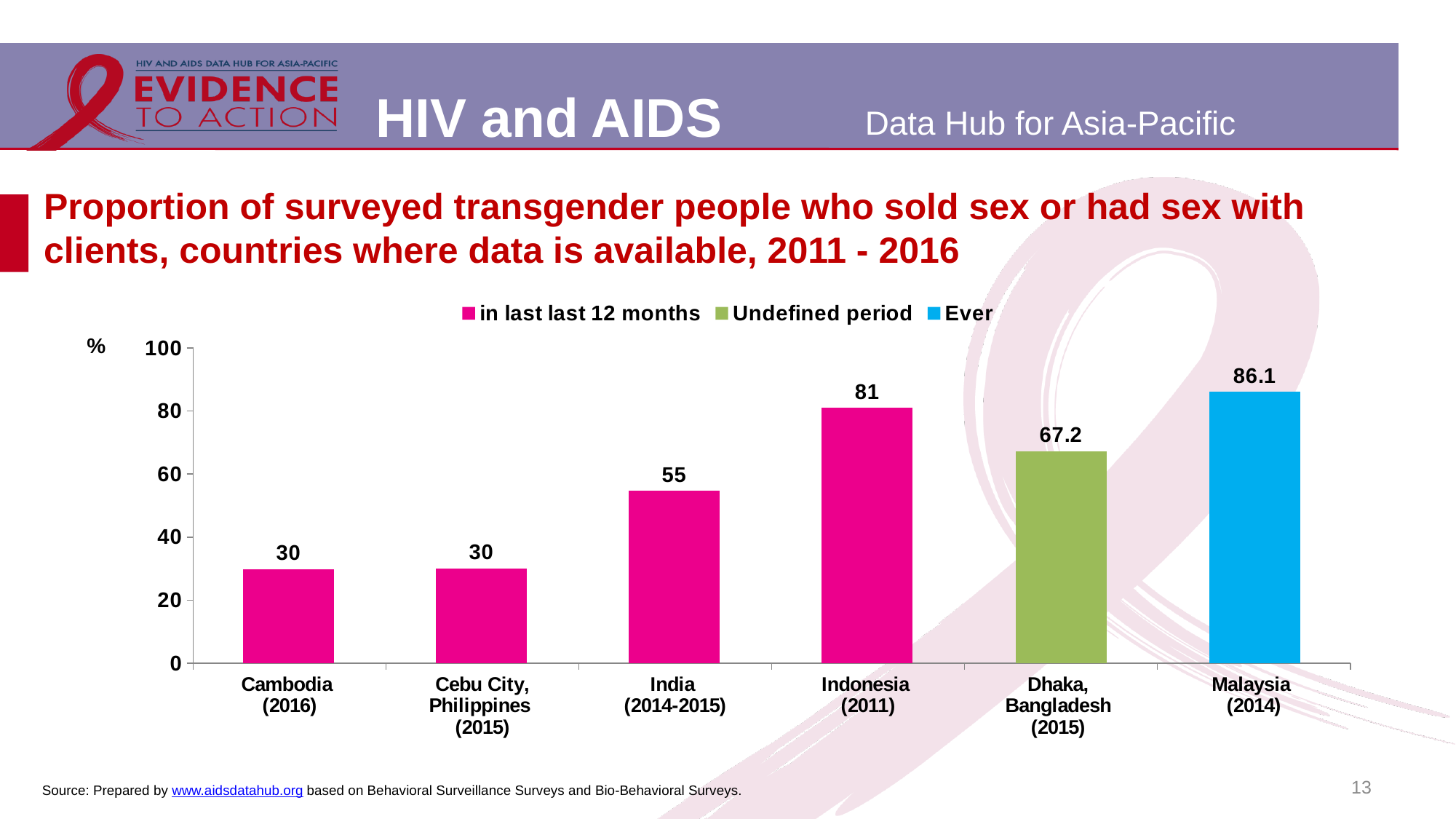
What is the difference between the values for Indonesia (2011) and India (2014-2015)? 26 How many series does the legend list? 3 What kind of chart is shown? bar chart What is the value for Dhaka, Bangladesh (2015)? 67.2 Is the value for Cambodia (2016) greater or less than 40? less What is the value for Indonesia (2011)? 81 Which series does the Malaysia (2014) bar belong to, according to the legend? Ever Which is larger, the value for Dhaka, Bangladesh (2015) or the value for India (2014-2015)? Dhaka, Bangladesh (2015) What is the value for Malaysia (2014)? 86.1 Which category has the highest value? Malaysia (2014) How many categories are shown on the x axis? 6 What is the difference between the values for Malaysia (2014) and Dhaka, Bangladesh (2015)? 18.9